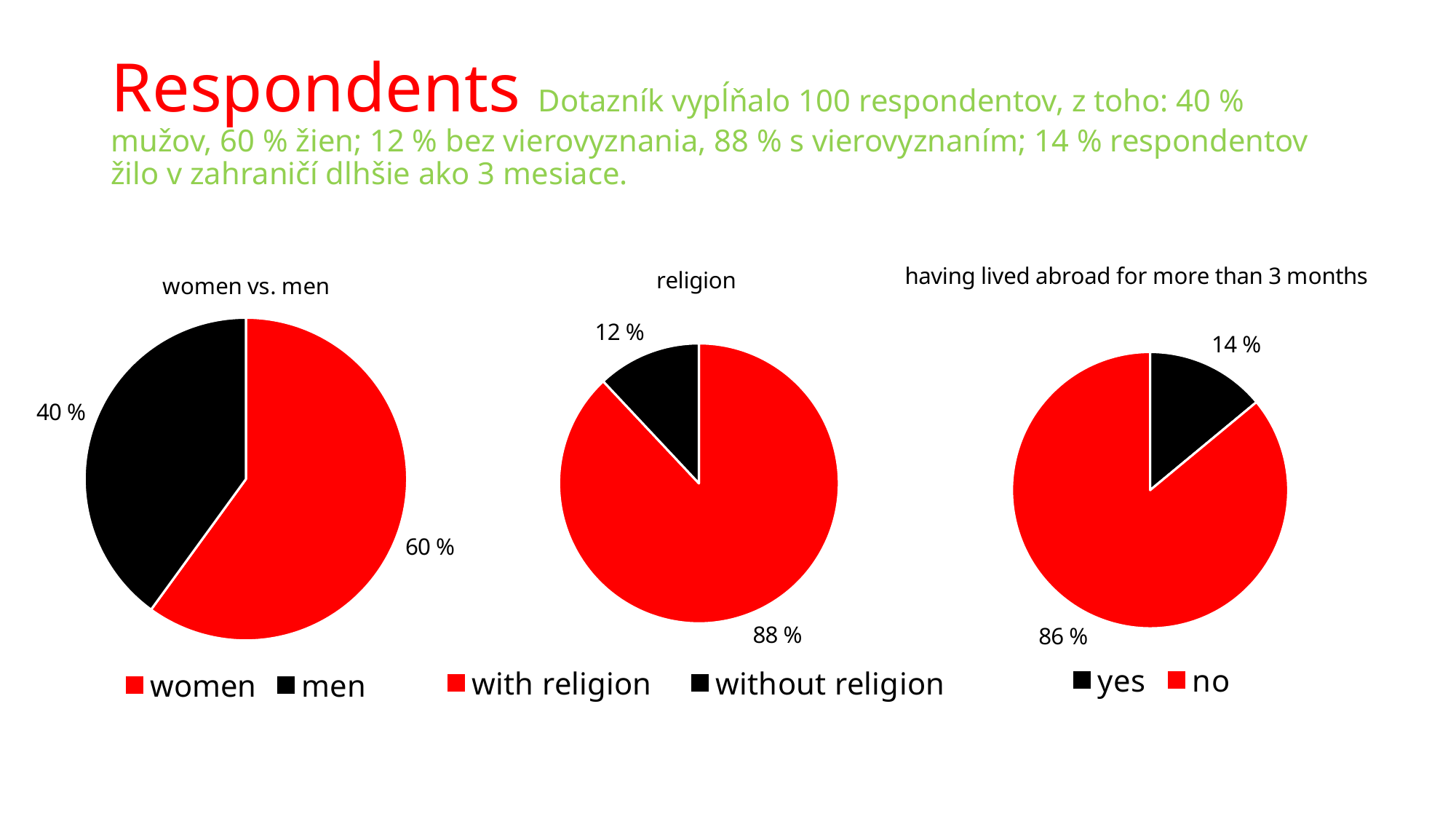
What type of chart is the 'religion' chart? pie chart In the 'religion' chart, what share of respondents are without religion? 12 % In the 'women vs. men' chart, which category has the larger share? women In the 'having lived abroad for more than 3 months' chart, what is the difference between the no and yes shares? 72 % In the 'women vs. men' chart, what share of respondents are men? 40 % How many slices does the 'women vs. men' chart have? 2 In the 'religion' chart, which category has the smaller share? without religion In the 'women vs. men' chart, what is the difference between the women and men shares? 20 % In the 'having lived abroad for more than 3 months' chart, what share of respondents answered no? 86 % In the 'having lived abroad for more than 3 months' chart, what share of respondents answered yes? 14 % In the 'religion' chart, what share of respondents are with religion? 88 % In the 'women vs. men' chart, what share of respondents are women? 60 %